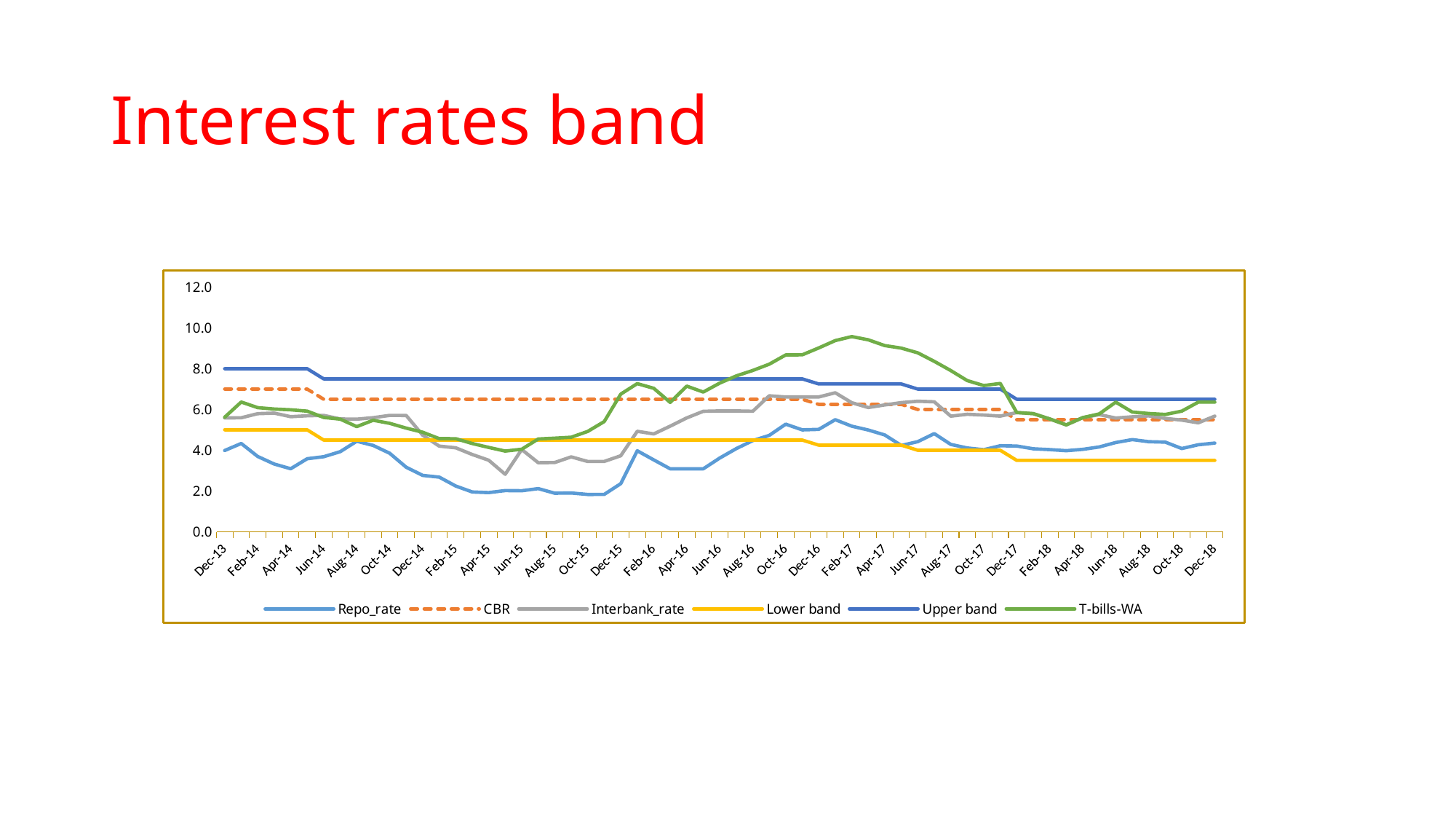
At Feb-17, which is higher: T-bills-WA or the Upper band? T-bills-WA How many series does the legend list? 6 What is the value of the Upper band at Dec-13? 8.0 Is the value of T-bills-WA at Feb-17 greater or less than 8.0? greater Which series reaches the highest value anywhere on the chart? T-bills-WA Is the value of Repo_rate at Apr-15 greater or less than 4.0? less Which series falls to the lowest value anywhere on the chart? Repo_rate Does the T-bills-WA line rise or fall between Feb-17 and Dec-17? fall Is the value of the Lower band at Dec-18 greater or less than 4.0? less What is the title of the slide containing the chart? Interest rates band Which series is drawn with a dashed line? CBR What type of chart is shown on the slide? line chart